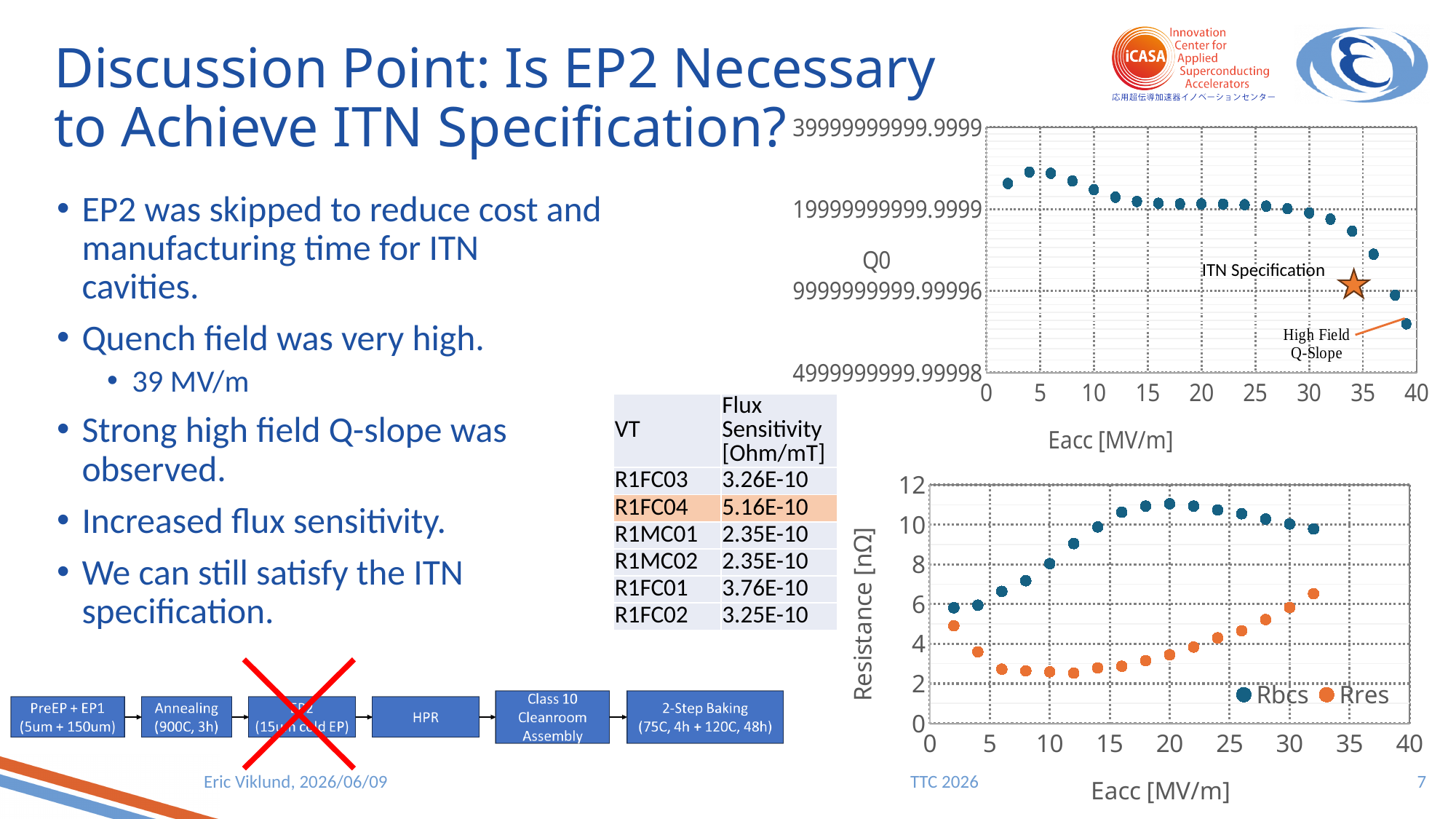
In the top-right Q0 chart, is the Q0 value at the highest Eacc point (about 39 MV/m) greater or less than 9999999999.99996? less What kind of chart is the bottom-right chart of Resistance versus Eacc? scatter chart In the bottom-right Resistance chart, is the Rbcs value at 20 MV/m greater or less than 10? greater What kind of chart is the top-right Q0 versus Eacc chart? scatter chart In the bottom-right Resistance chart, is the Rres value at 20 MV/m greater or less than 4? less What is the y-axis label of the bottom-right chart? Resistance [nΩ] In the bottom-right Resistance chart, does the Rres series generally rise or fall as Eacc increases from 10 to 32 MV/m? rise How many series does the legend of the bottom-right Resistance chart list? 2 What are the two series named in the legend of the bottom-right Resistance chart? Rbcs and Rres In the top-right Q0 chart, does Q0 rise or fall as Eacc increases from 30 to 40 MV/m? fall In the bottom-right Resistance chart, which series has the larger value at 20 MV/m, Rbcs or Rres? Rbcs